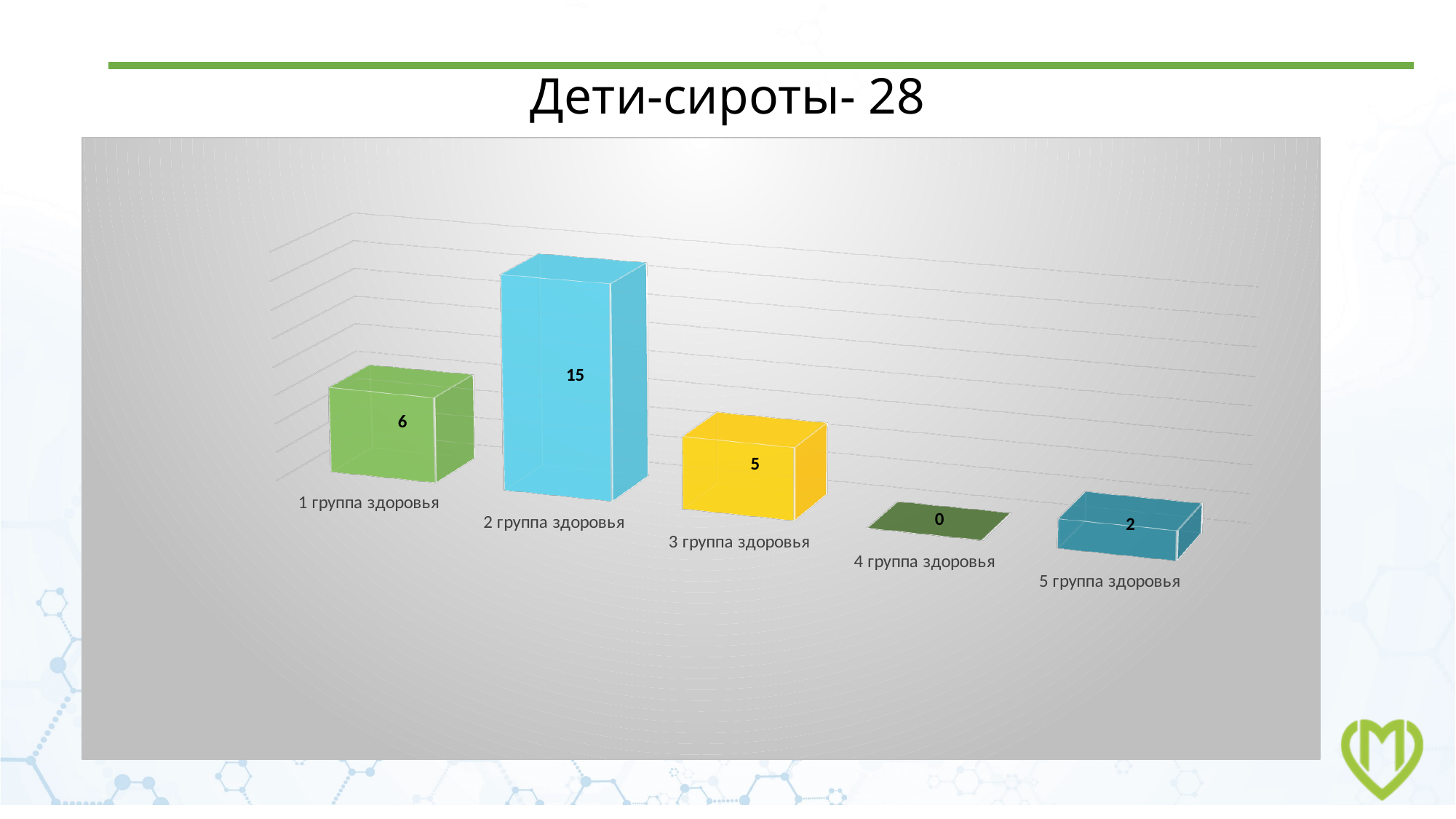
Which is larger, the value for 3 группа здоровья or 5 группа здоровья? 3 группа здоровья What kind of chart is shown on the slide? bar chart How many health group categories are shown in the chart? 5 What is the value for 1 группа здоровья? 6 What is the title of the slide? Дети-сироты- 28 Which health group has the highest value? 2 группа здоровья What is the value for 4 группа здоровья? 0 What is the value for 2 группа здоровья? 15 What is the value for 5 группа здоровья? 2 What is the difference between the values for 2 группа здоровья and 1 группа здоровья? 9 What is the value for 3 группа здоровья? 5 Which health group has the lowest value? 4 группа здоровья